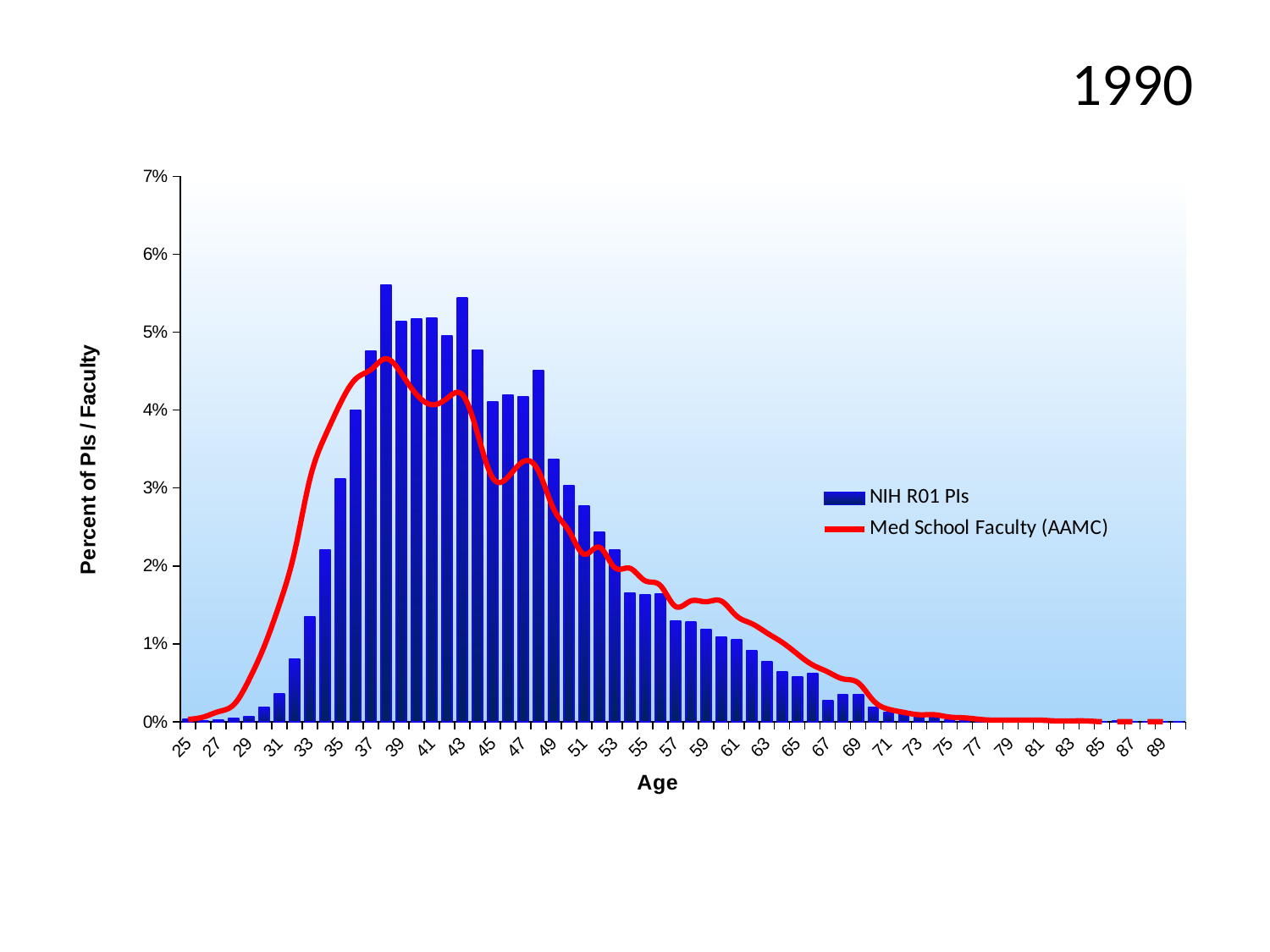
Which is larger at age 33: the NIH R01 PIs bar or the Med School Faculty (AAMC) line? Med School Faculty (AAMC) Which is larger at age 47: the NIH R01 PIs bar or the Med School Faculty (AAMC) line? NIH R01 PIs Is the Med School Faculty (AAMC) value at age 39 greater or less than 4%? greater What is the title of the y axis? Percent of PIs / Faculty How many series does the legend list? 2 What kind of chart is shown on the slide? A bar chart with a line overlay Is the value for NIH R01 PIs at age 43 greater or less than 5%? greater Is the value for NIH R01 PIs at age 55 greater or less than 2%? less What are the two series named in the legend? NIH R01 PIs and Med School Faculty (AAMC) Do the NIH R01 PIs values generally rise or fall from age 49 to age 69? fall